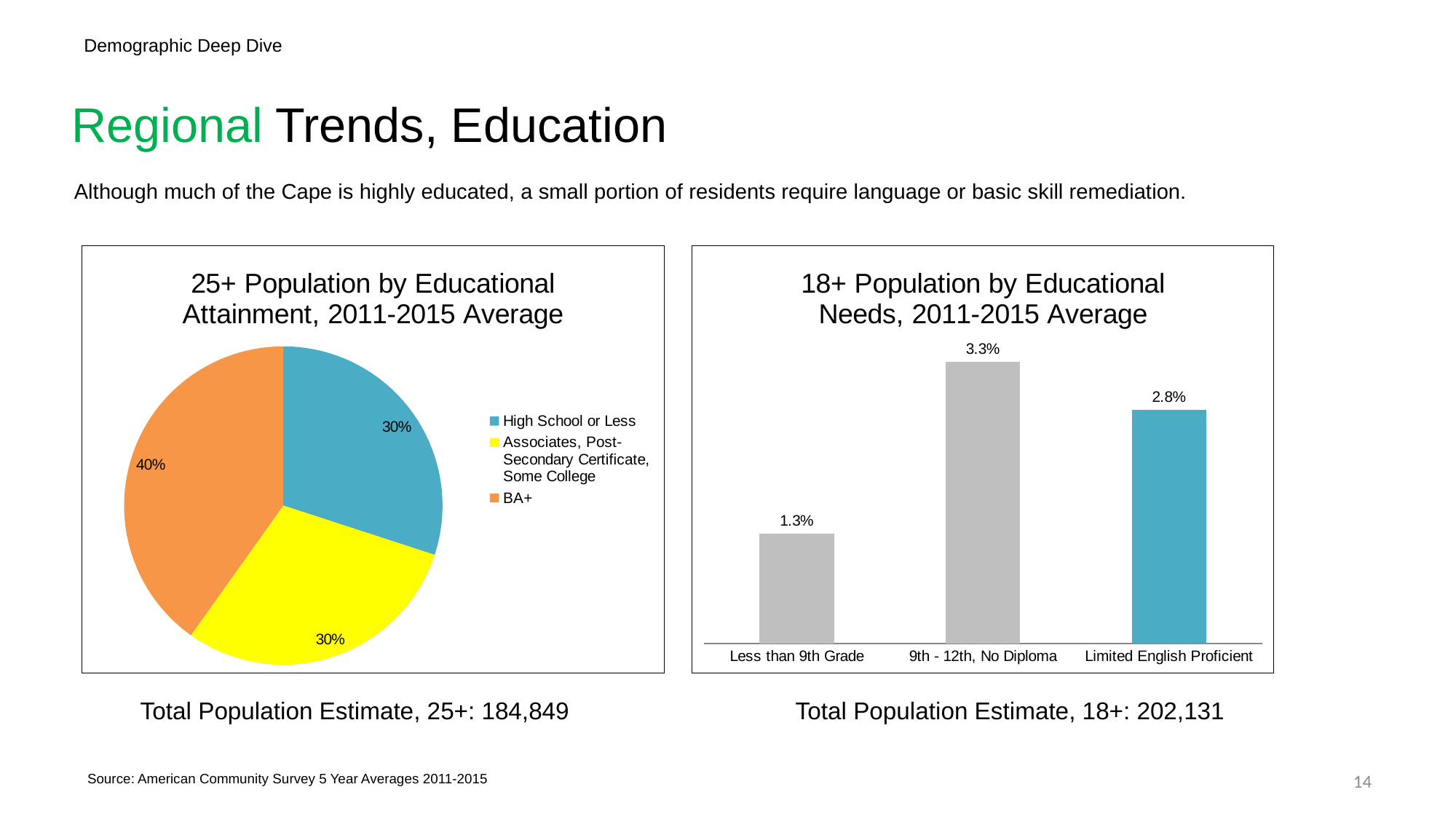
In the bar chart on the right, what is the difference between the values for '9th - 12th, No Diploma' and 'Less than 9th Grade'? 2.0% In the pie chart on the left, which category has the largest share? BA+ In the bar chart on the right, which is larger: the value for '9th - 12th, No Diploma' or 'Limited English Proficient'? 9th - 12th, No Diploma In the pie chart titled '25+ Population by Educational Attainment, 2011-2015 Average', what share of the population has a BA+? 40% In the pie chart on the left, what percentage is shown for 'High School or Less'? 30% What kind of chart is the chart on the left of the slide? Pie chart How many slices does the pie chart on the left have? 3 In the bar chart on the right, which category has the highest value? 9th - 12th, No Diploma In the bar chart on the right, what is the value for 'Limited English Proficient'? 2.8% What kind of chart is the chart on the right of the slide? Bar chart In the bar chart titled '18+ Population by Educational Needs, 2011-2015 Average', what is the value for 'Less than 9th Grade'? 1.3% In the bar chart on the right, which category has the lowest value? Less than 9th Grade